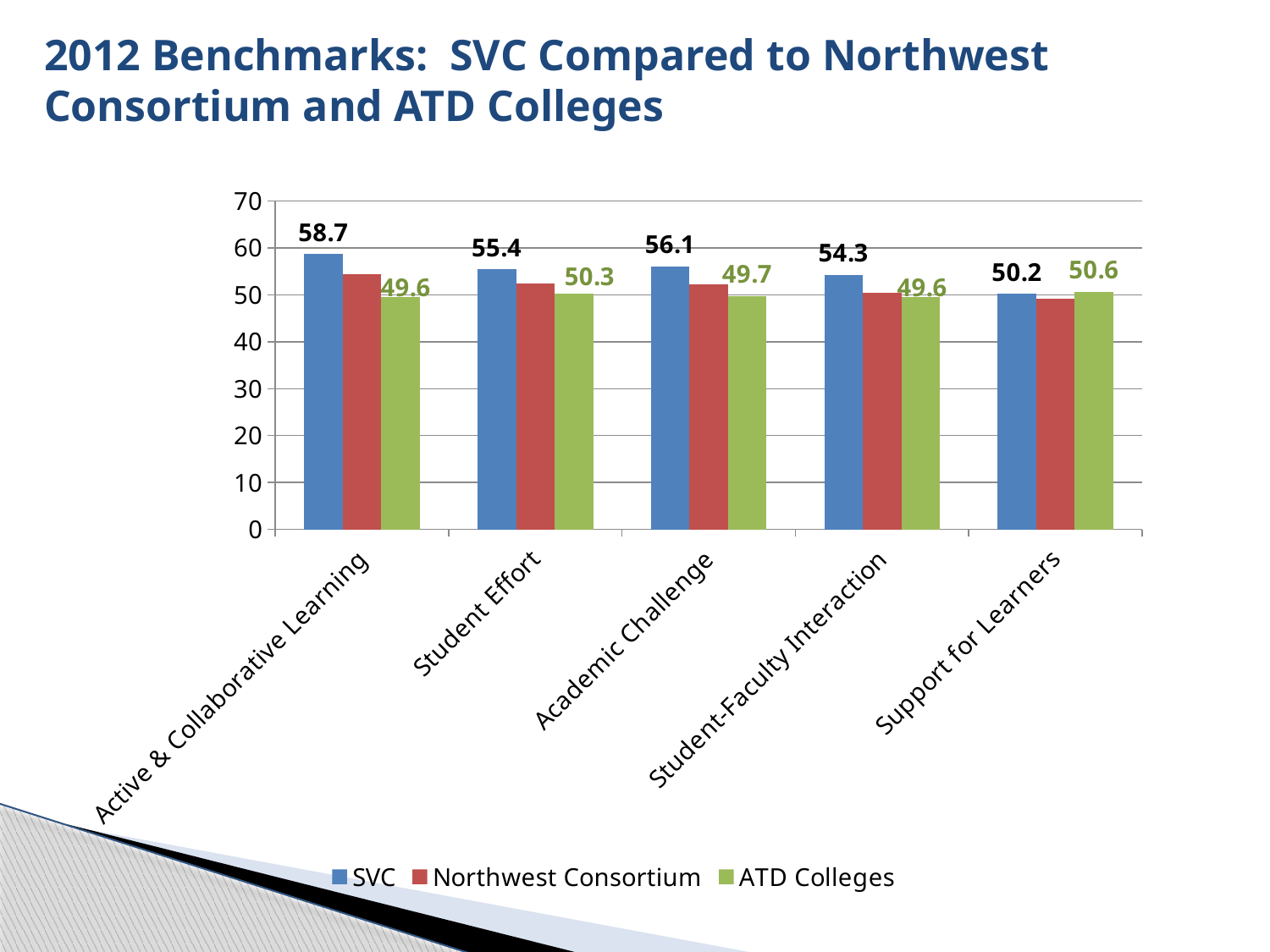
Which category has the lowest SVC value? Support for Learners What kind of chart is shown on the slide? Bar chart What is the ATD Colleges value for Student Effort? 50.3 What is the ATD Colleges value for Support for Learners? 50.6 How many benchmark categories are shown on the x axis? 5 Which category has the highest SVC value? Active & Collaborative Learning Is the Northwest Consortium value for Active & Collaborative Learning greater or less than 50? greater What is the difference between the SVC and ATD Colleges values for Active & Collaborative Learning? 9.1 How many series does the legend list? 3 For Support for Learners, which is larger: the SVC value or the ATD Colleges value? ATD Colleges What is the SVC value for Active & Collaborative Learning? 58.7 What is the SVC value for Student-Faculty Interaction? 54.3